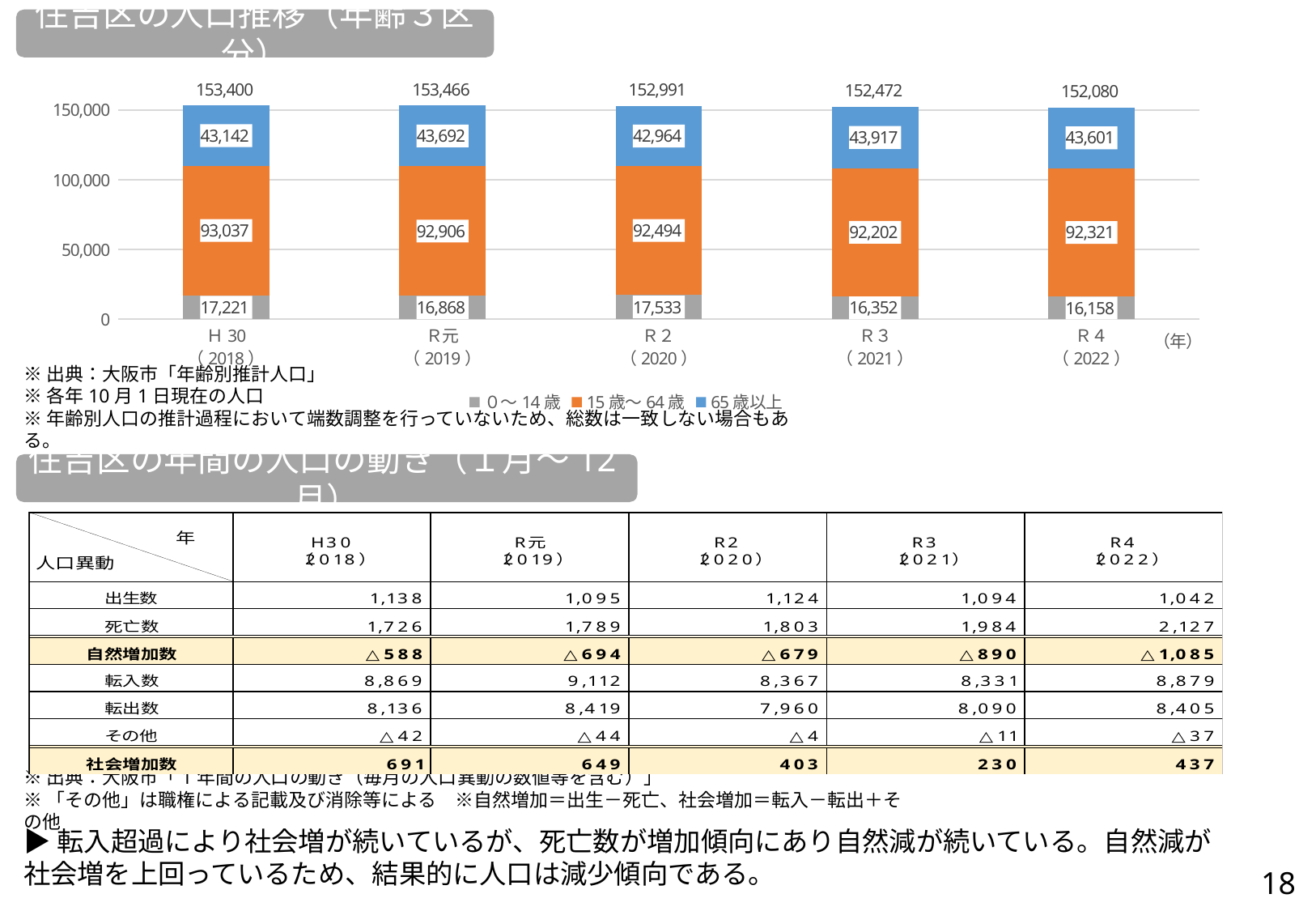
In which year is the 0～14歳 value the highest? R2 (2020) What is the value for the 65歳以上 series in H30 (2018)? 43,142 In which year is the 65歳以上 value the lowest? R2 (2020) What kind of chart is shown on the slide? Stacked bar chart How many series does the chart's legend list? 3 What is the value for the 15歳～64歳 series in R2 (2020)? 92,494 Which is larger, the 65歳以上 value in R元 (2019) or in R3 (2021)? R3 (2021) Does the total population rise or fall from R元 (2019) to R4 (2022)? Falls What is the total population shown above the stacked bar for R3 (2021)? 152,472 What is the value for the 0～14歳 series in R4 (2022)? 16,158 What is the difference between the 15歳～64歳 value in H30 (2018) and in R4 (2022)? 716 How many years are shown on the x axis of the chart? 5